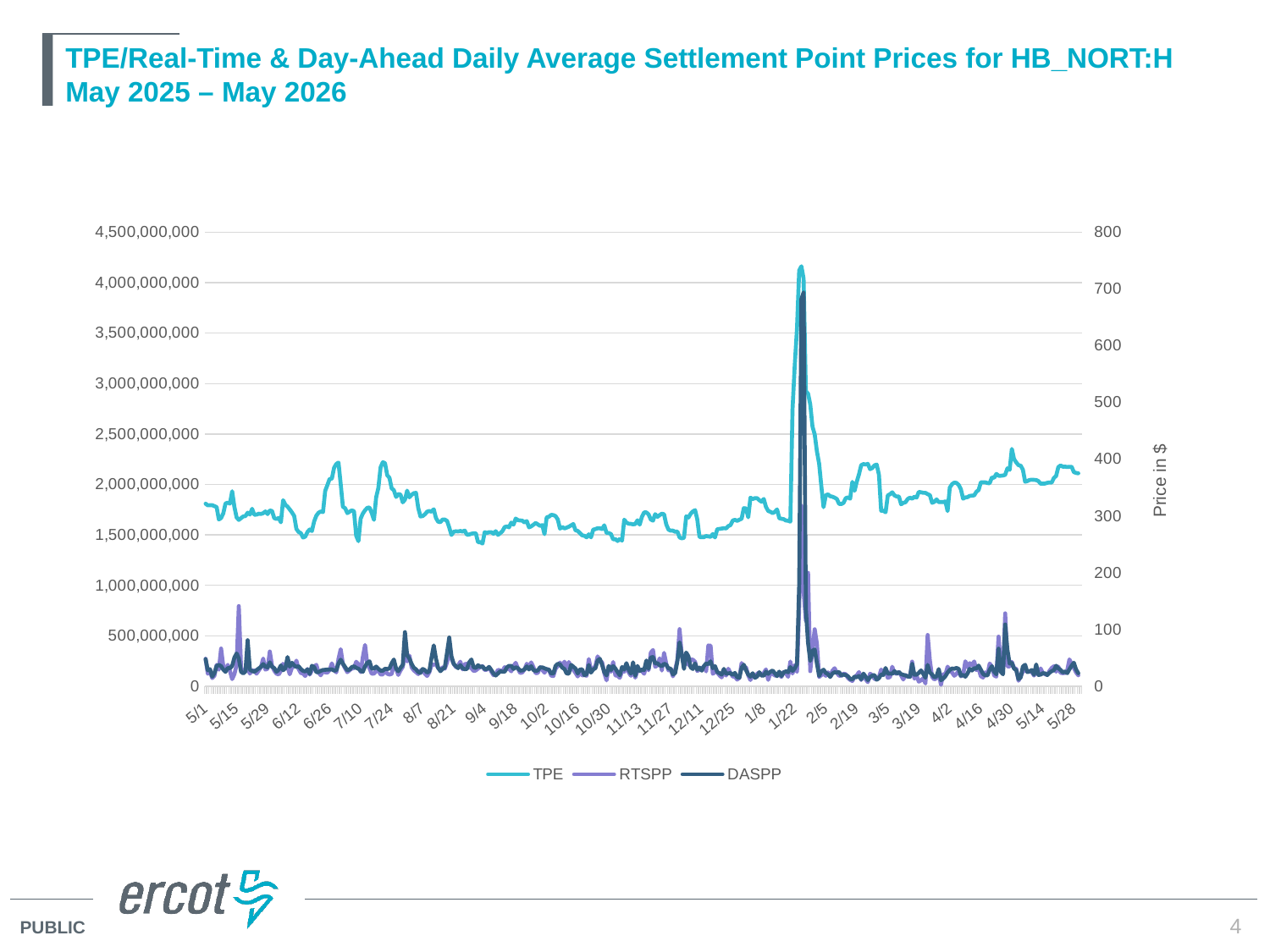
What are the names of the series in the legend? TPE, RTSPP, DASPP How many series does the legend list? 3 Is the lowest value of the TPE series greater or less than 1,000,000,000 on the left axis? greater How many date labels are shown along the x axis? 29 Comparing the start (5/1) and the end (5/28) of the chart, does the TPE series end higher or lower than it started? higher Is the TPE value at 5/1 greater or less than 1,500,000,000 on the left axis? greater Near which x-axis label does the TPE series reach its highest point? 1/22 Is the peak of the RTSPP series greater or less than 600 on the right axis? less What is the title of the right-hand vertical axis? Price in $ What kind of chart is shown on the slide? line chart Which is larger for the TPE series: the value near 6/26 or the value near 9/4? 6/26